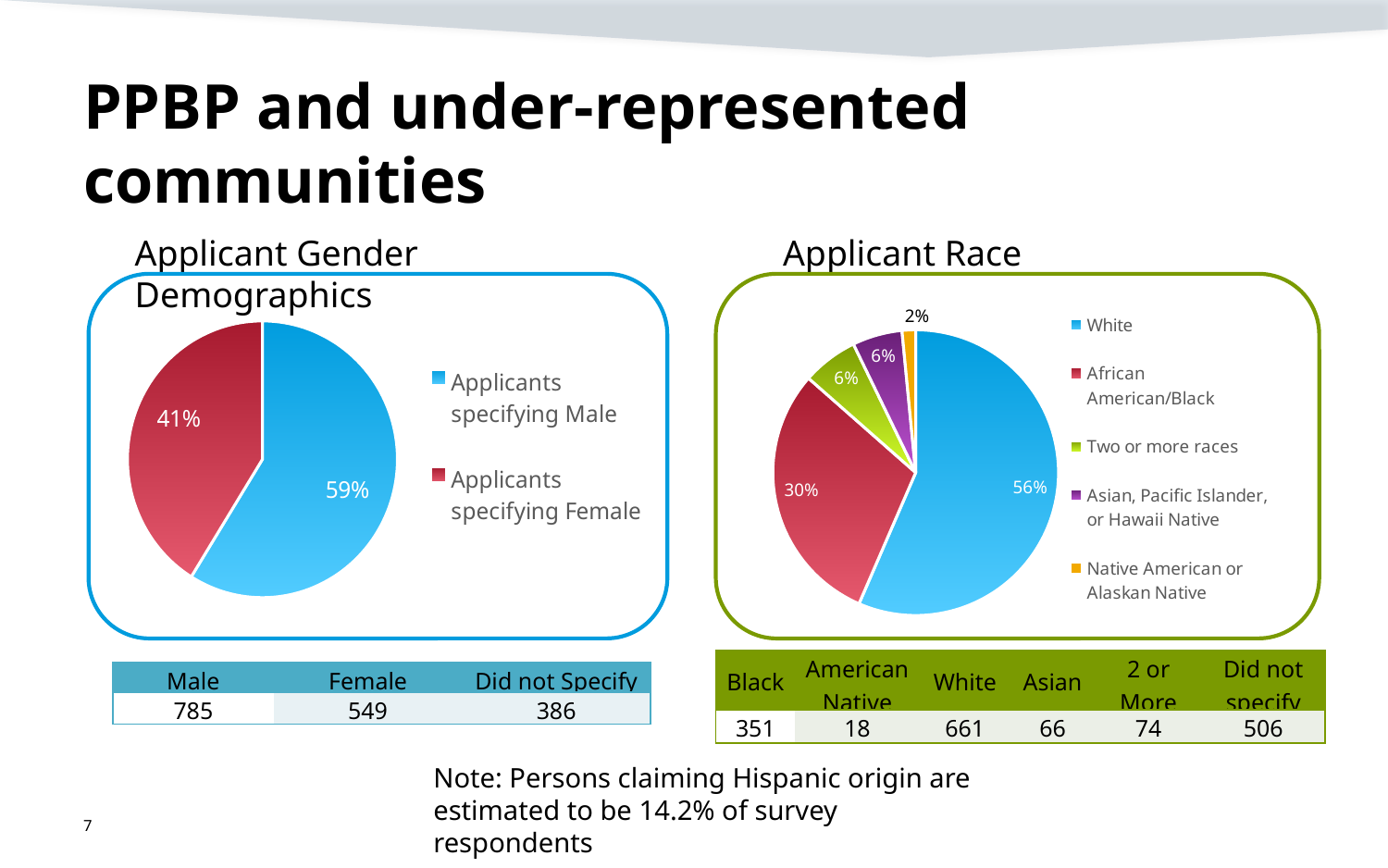
In the Applicant Race pie chart, what share is Native American or Alaskan Native? 2% In the Applicant Race pie chart, what share is White? 56% In the Applicant Gender Demographics chart, which category has the larger share? Applicants specifying Male How many categories does the legend of the Applicant Race pie chart list? 5 How many series does the legend of the Applicant Gender Demographics chart list? 2 In the Applicant Gender Demographics pie chart, what share of applicants specified Male? 59% In the Applicant Race pie chart, what is the difference in percentage points between the White and African American/Black shares? 26 In the Applicant Race pie chart, which category has the smallest share? Native American or Alaskan Native What type of chart is the Applicant Gender Demographics chart? Pie chart In the Applicant Gender Demographics chart, what is the difference in percentage points between the Male and Female shares? 18